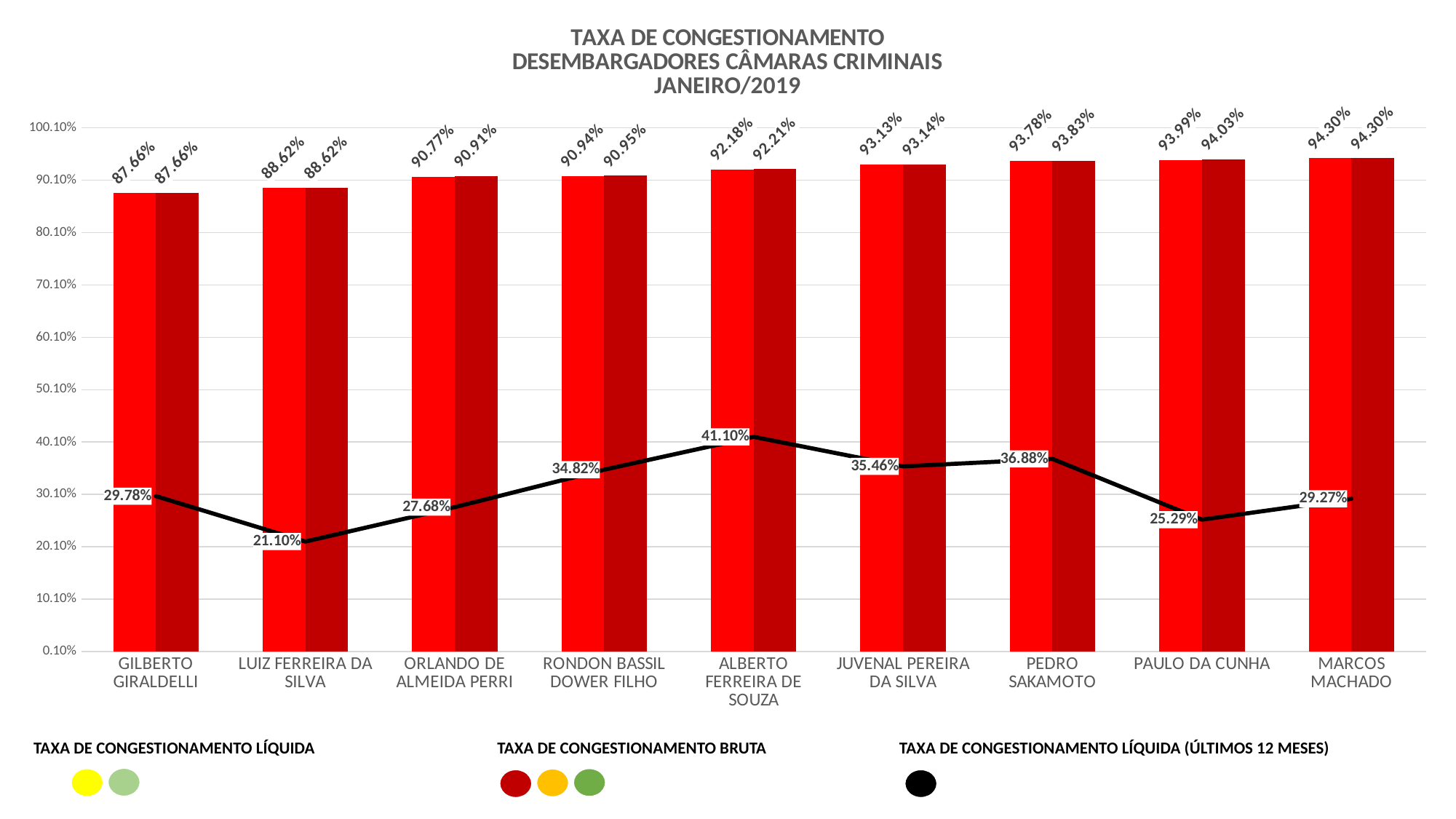
How many series does the legend list? 3 What is the value of the black line (últimos 12 meses) for Paulo da Cunha? 25.29% What is the value of the black line (Taxa de Congestionamento Líquida (últimos 12 meses)) for Alberto Ferreira de Souza? 41.10% What kind of chart is this? Bar chart with a line series Is the black line value for Rondon Bassil Dower Filho greater or less than 30.10%? greater Which is larger: the black line value for Pedro Sakamoto or for Juvenal Pereira da Silva? Pedro Sakamoto What is the difference between the black line values for Alberto Ferreira de Souza (41.10%) and Luiz Ferreira da Silva (21.10%)? 20.00% Do the red bar values rise or fall from left to right along the x axis? Rise How many desembargadores are shown on the x axis? 9 Which desembargador has the highest value on the black line (últimos 12 meses)? Alberto Ferreira de Souza Which desembargador has the lowest value on the black line (últimos 12 meses)? Luiz Ferreira da Silva What is the value of the black line (últimos 12 meses) for Luiz Ferreira da Silva? 21.10%